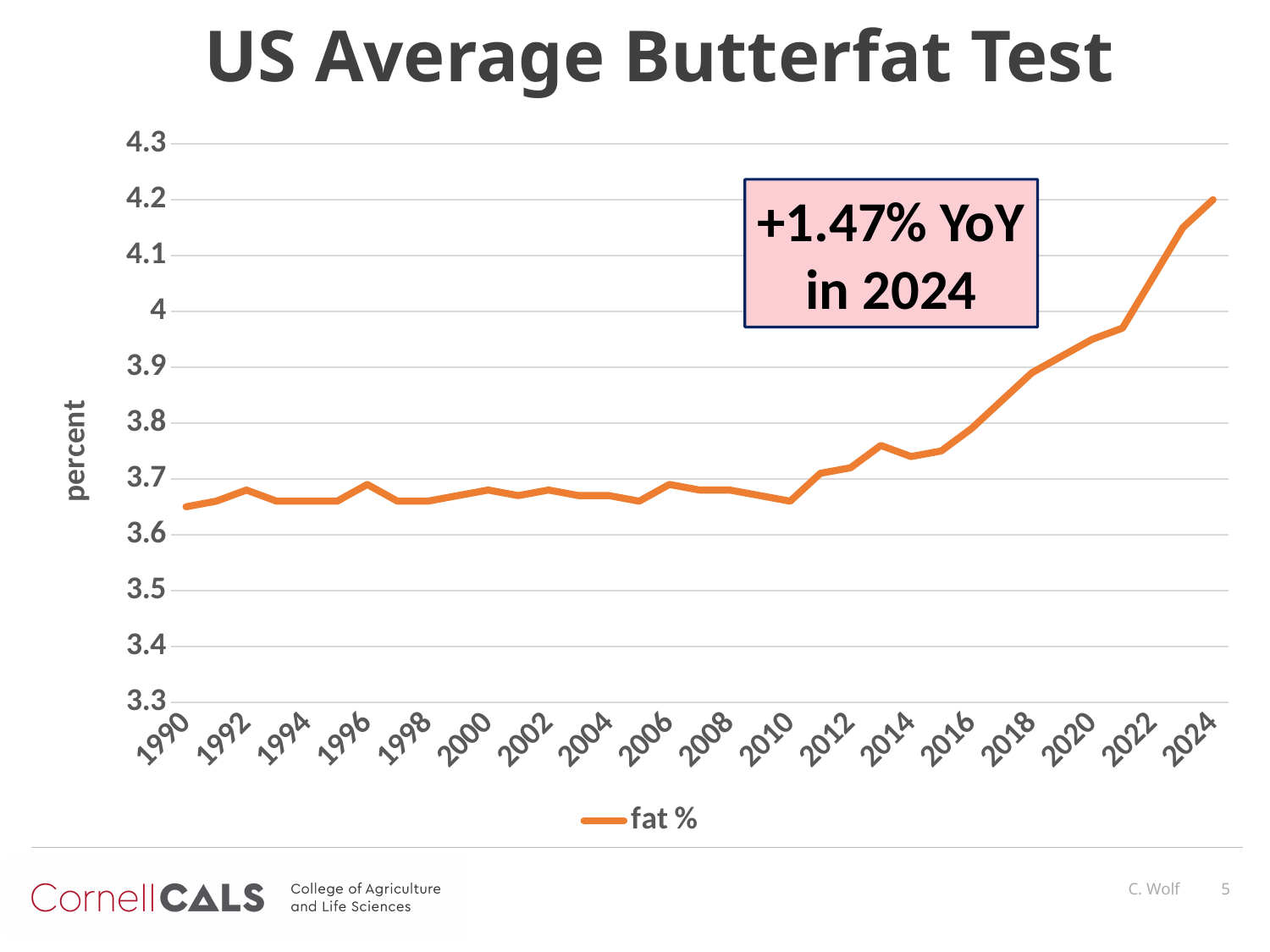
Is the fat % value for 2020 greater or less than 3.9? greater What is the name of the series shown in the legend? fat % Is the fat % value for 2010 greater or less than 3.7? less What kind of chart is shown on the slide? line chart Is the fat % value for 2022 greater or less than 4? greater Which year has the highest fat % value? 2024 What is the label on the y axis? percent How many series does the legend list? 1 Which year has the larger fat % value, 2014 or 2006? 2014 Does the fat % value generally rise or fall from 2010 to 2024? rise